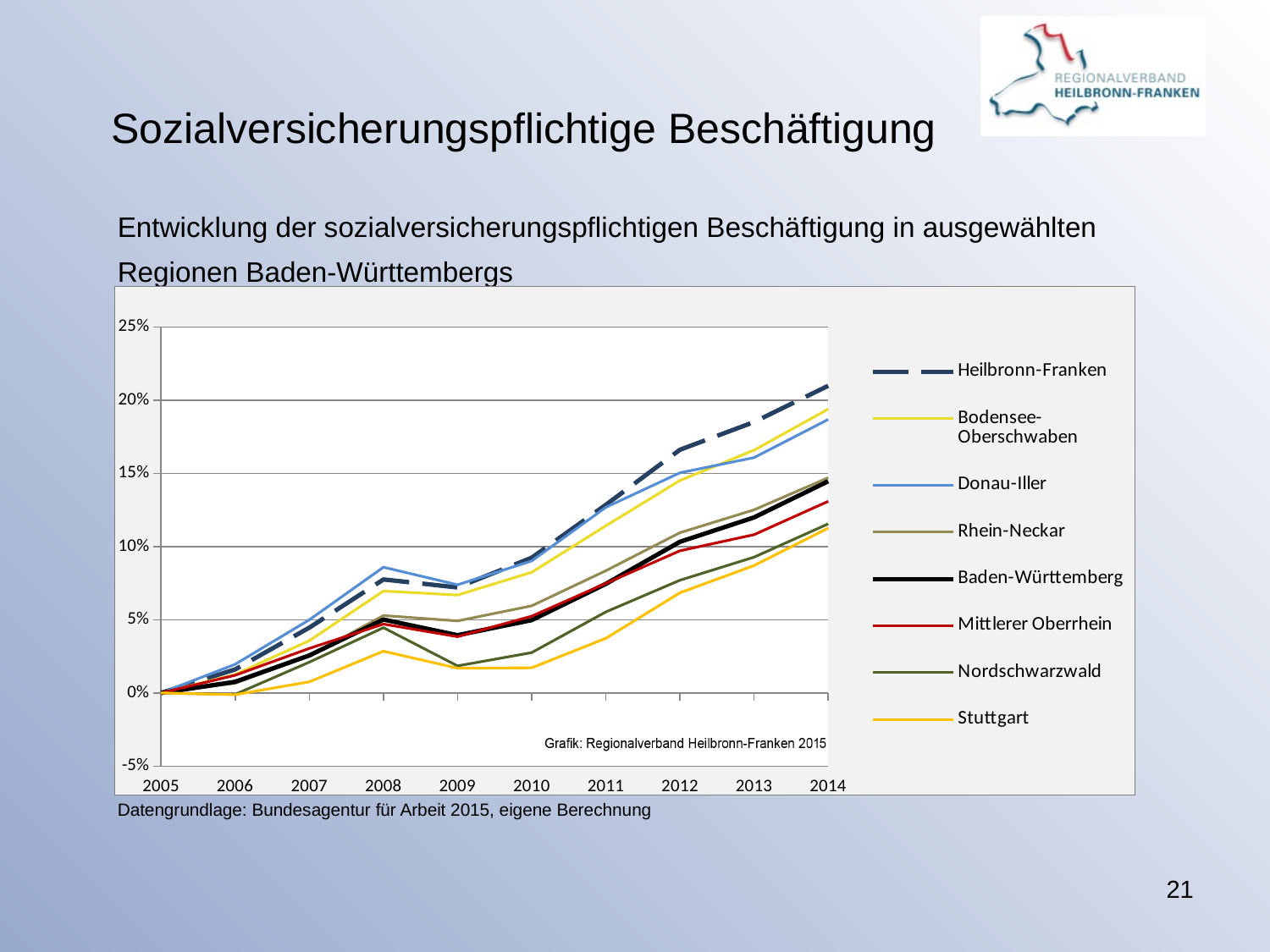
Is the value for Donau-Iller in 2008 greater or less than 5%? greater How many series does the legend list? 8 Which region has the highest value in 2014? Heilbronn-Franken In 2014, which is larger: Rhein-Neckar or Mittlerer Oberrhein? Rhein-Neckar Is the value for Stuttgart in 2014 greater or less than 15%? less How many years are shown on the x axis? 10 Which series is drawn with a dashed line? Heilbronn-Franken What kind of chart is shown on the slide? line chart Does the Heilbronn-Franken line rise or fall from 2009 to 2014? rises What is the value for Baden-Württemberg in 2005? 0% Is the value for Heilbronn-Franken in 2014 greater or less than 20%? greater Which region has the lowest value in 2008? Stuttgart